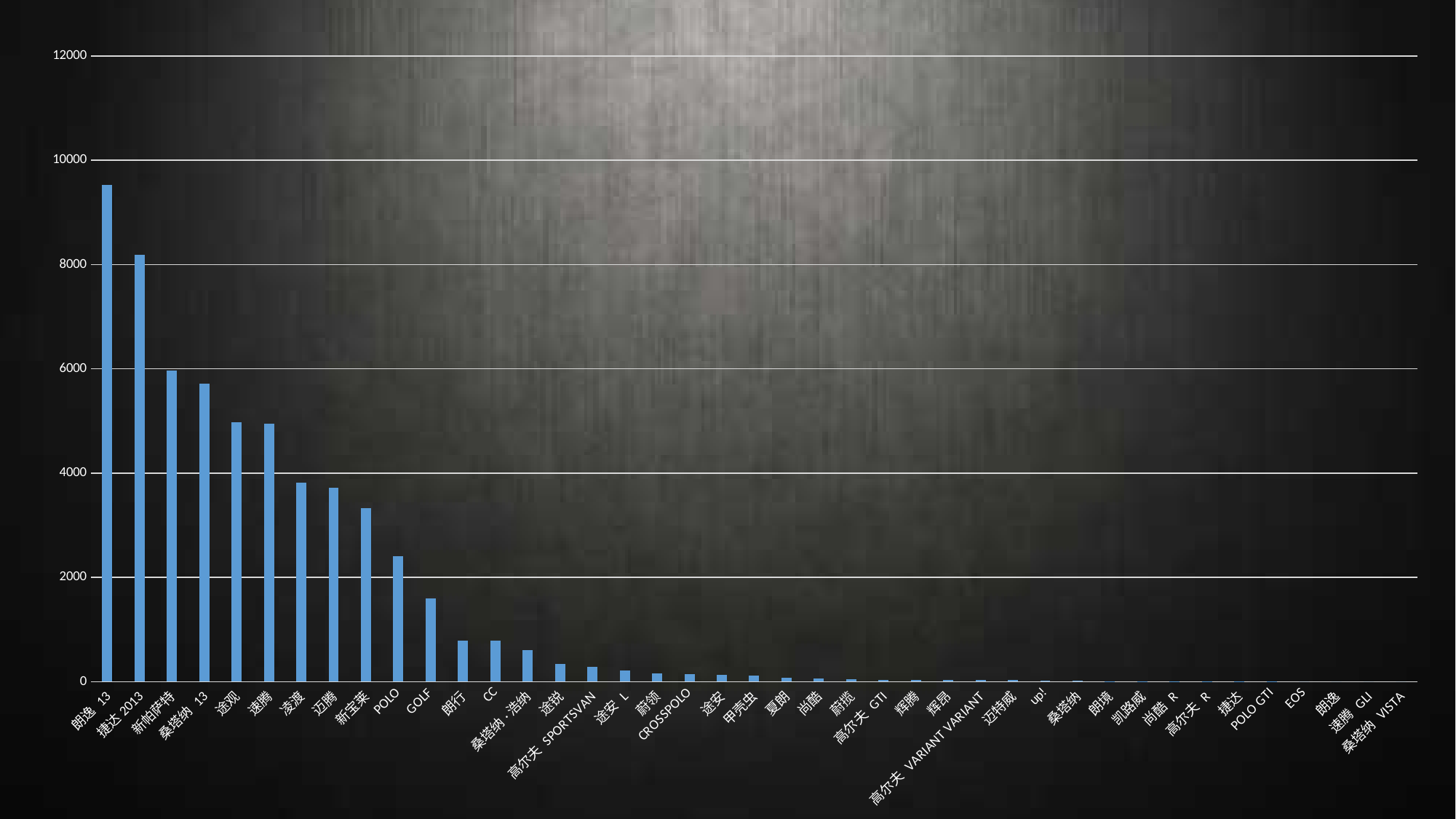
Which is larger, the value for 朗逸 13 or the value for 捷达 2013? 朗逸 13 Is the value for 凌渡 greater or less than 4000? less Is the value for GOLF greater or less than 2000? less What is the highest value shown on the vertical axis? 12000 Is the value for 捷达 2013 greater or less than 8000? greater Do the values rise or fall moving from left to right along the x axis? fall Which is larger, the value for 新宝莱 or the value for POLO? 新宝莱 Which category has the highest value? 朗逸 13 What kind of chart is shown on the slide? bar chart